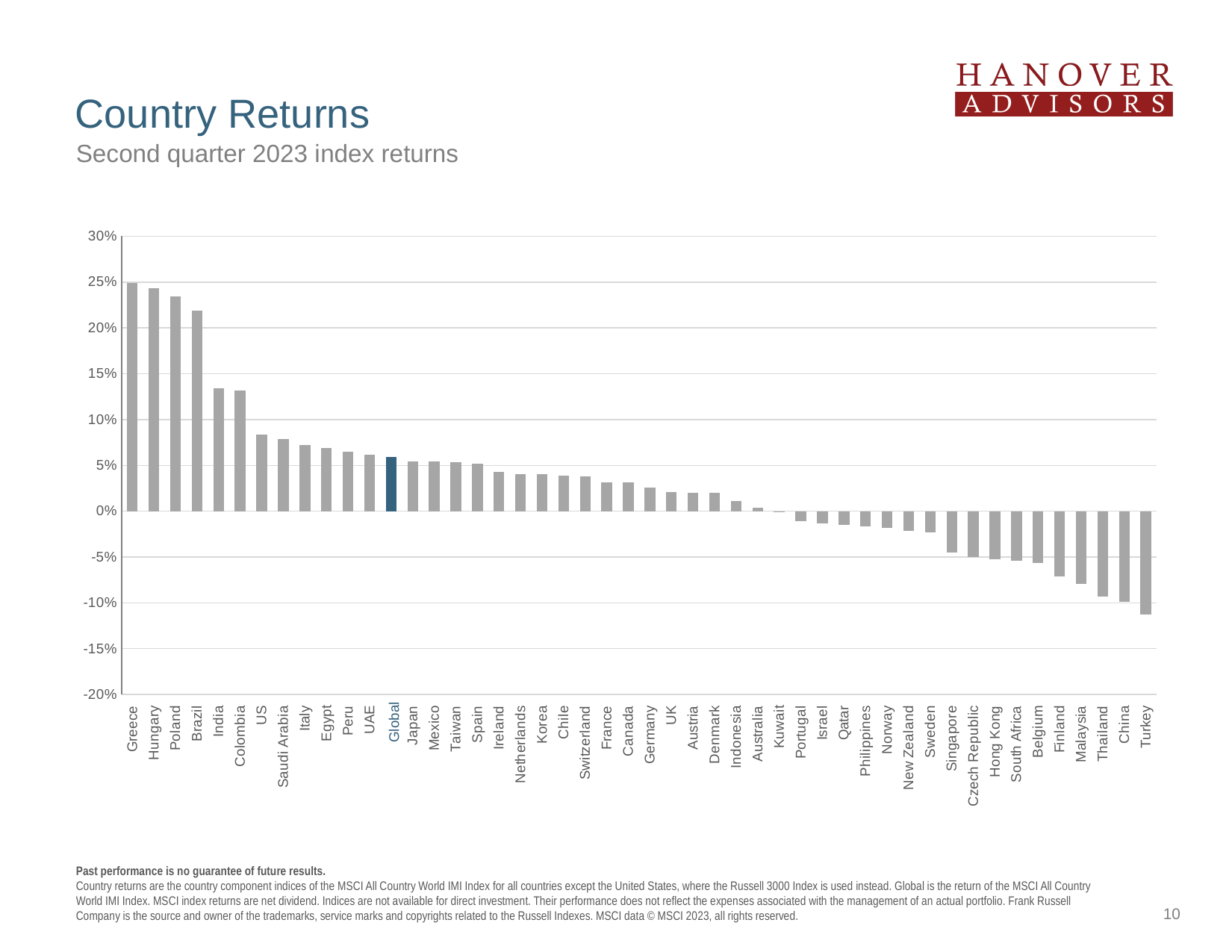
Do the values rise or fall moving from left to right along the x axis? Fall What kind of chart is shown on the slide? Bar chart Which country has the lowest second quarter 2023 index return? Turkey Is the value for Greece greater or less than 20%? greater How many categories (bars) are plotted on the chart? 48 Is the value for US greater or less than 10%? less Is the value for India greater or less than 10%? greater Which bar is shown in a different (dark blue) colour from the others? Global Which country has the highest second quarter 2023 index return? Greece Which has the larger return, India or US? India